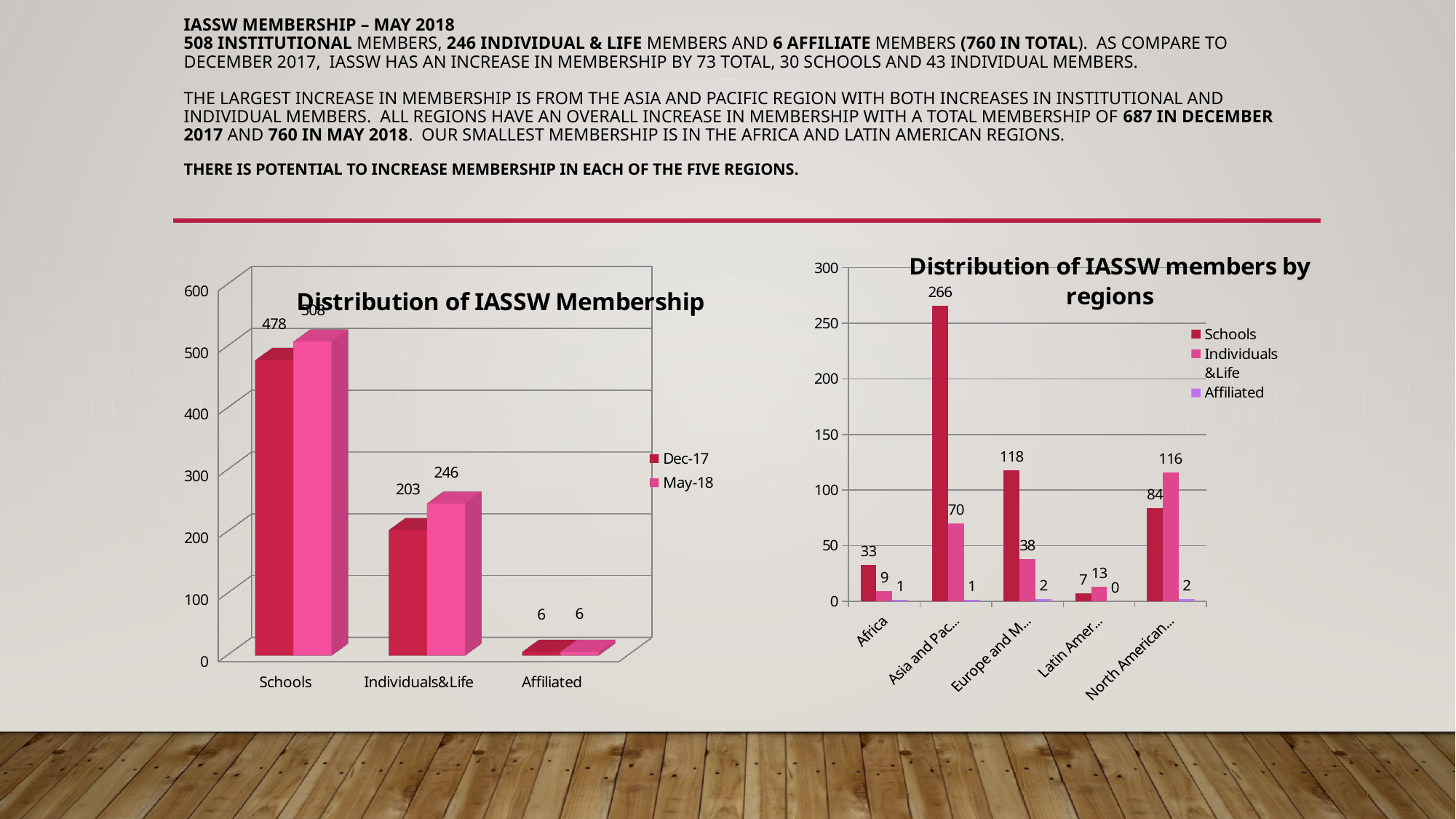
In the 'Distribution of IASSW members by regions' chart, which is larger for the North American region: Schools or Individuals &Life? Individuals &Life In the 'Distribution of IASSW Membership' chart, what is the May-18 value for Individuals&Life? 246 What kind of chart is 'Distribution of IASSW Membership'? Bar chart In the 'Distribution of IASSW Membership' chart, what is the Dec-17 value for Schools? 478 In the 'Distribution of IASSW members by regions' chart, what is the Individuals &Life value for the North American region? 116 In the 'Distribution of IASSW members by regions' chart, which region has the highest Schools value? Asia and Pacific In the 'Distribution of IASSW members by regions' chart, how many regions are shown on the x axis? 5 In the 'Distribution of IASSW Membership' chart, what is the difference between the May-18 and Dec-17 values for Individuals&Life? 43 In the 'Distribution of IASSW Membership' chart, how many series does the legend list? 2 In the 'Distribution of IASSW members by regions' chart, how many series does the legend list? 3 In the 'Distribution of IASSW members by regions' chart, what is the Schools value for Africa? 33 In the 'Distribution of IASSW Membership' chart, which category has the lowest values? Affiliated